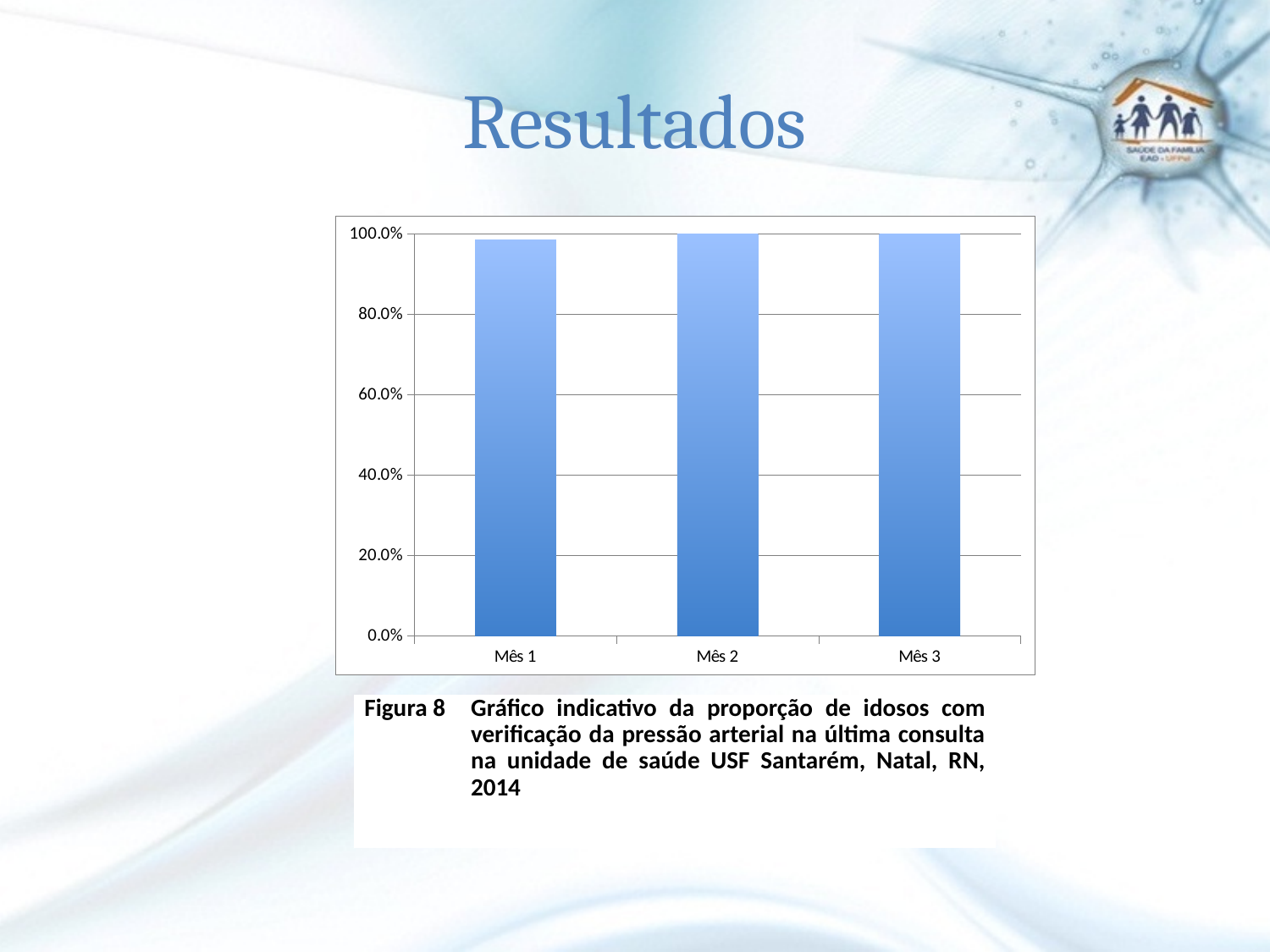
Is the value for Mês 1 greater or less than 80.0%? greater What is the value for Mês 2 in the chart? 100.0% What kind of chart is shown on the slide? bar chart What is the value for Mês 3 in the chart? 100.0% Which is larger, the value for Mês 1 or the value for Mês 2? Mês 2 How many categories are shown on the x axis of the chart? 3 Which category has the lowest value in the chart? Mês 1 Is the value for Mês 1 greater or less than 60.0%? greater What is the highest tick value shown on the y axis of the chart? 100.0% What is the figure number given in the caption below the chart? Figura 8